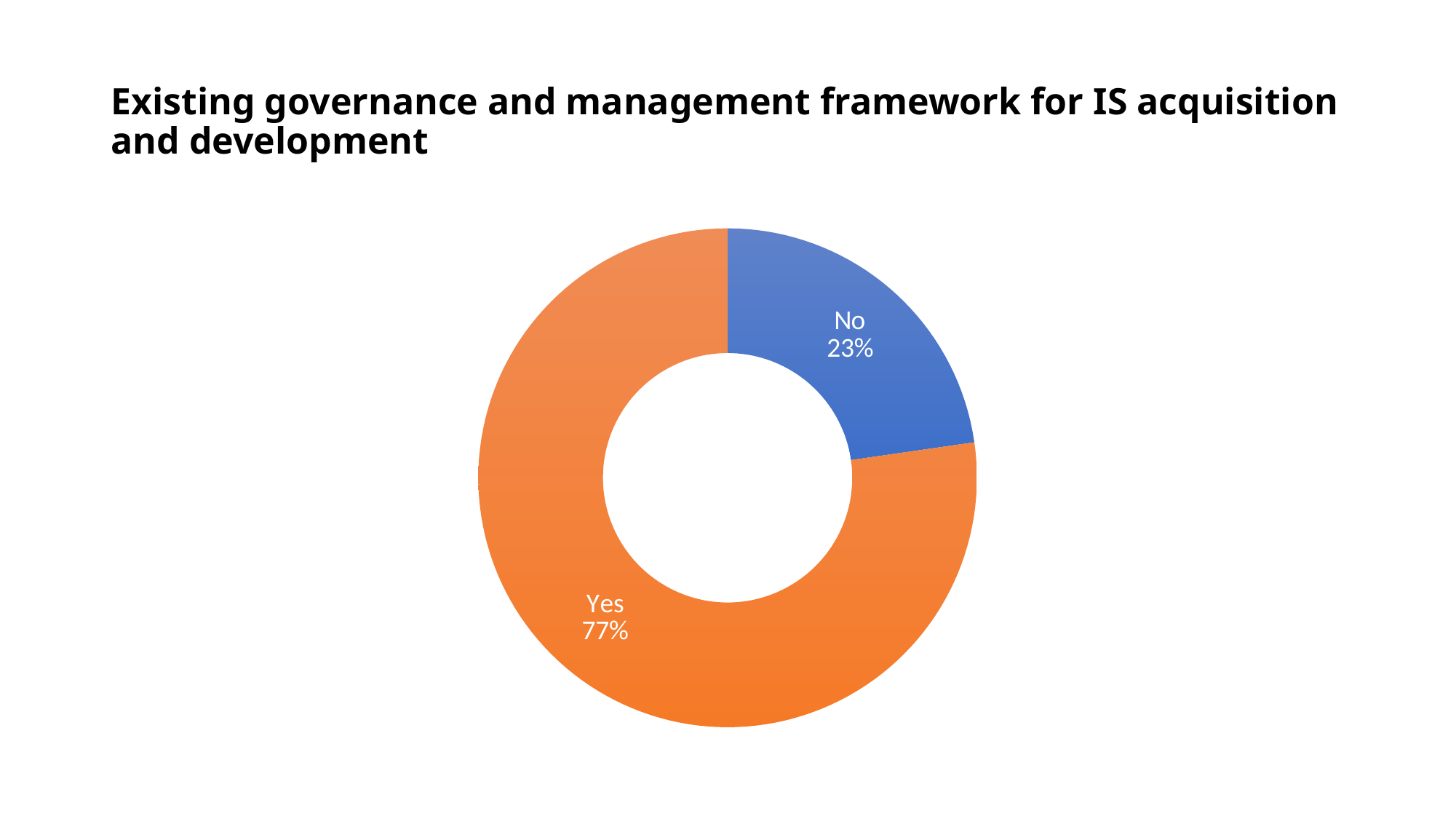
What percentage of the chart is labelled "Yes"? 77% Which category has the largest share of the chart? Yes What colour is the "Yes" segment of the chart? Orange What percentage of the chart is labelled "No"? 23% What kind of chart is shown on the slide? Doughnut chart How many categories are shown in the chart? 2 What is the title of the slide? Existing governance and management framework for IS acquisition and development Which category has the smallest share of the chart? No What share of the chart does the "No" slice represent? 23% What is the difference in percentage points between the "Yes" and "No" shares? 54 Which is larger, the "Yes" share or the "No" share? Yes